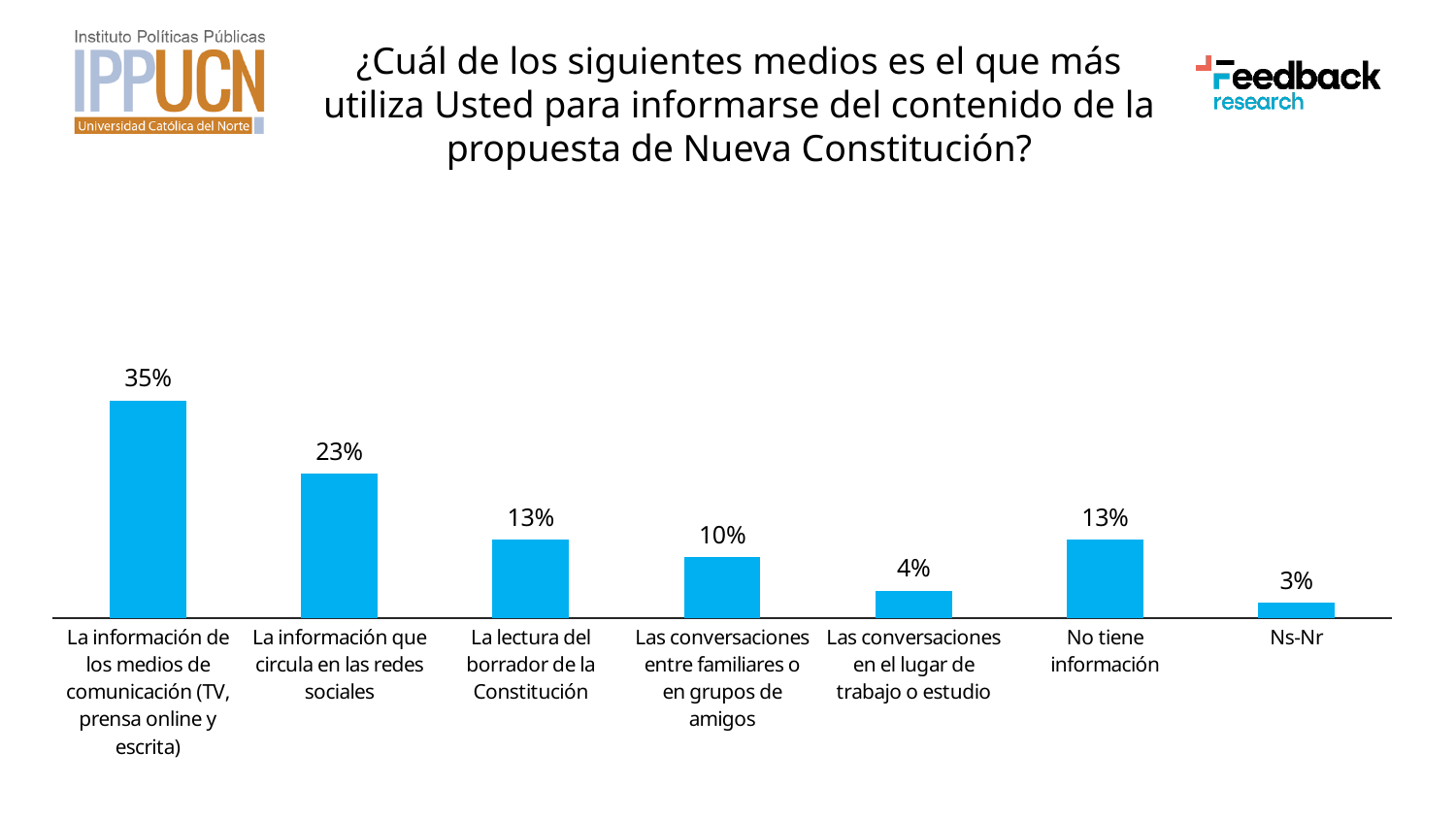
What is the value for "La información de los medios de comunicación (TV, prensa online y escrita)"? 35% What is the difference between the values for "La lectura del borrador de la Constitución" and "Ns-Nr"? 10% How many categories are shown in the chart? 7 What is the value for "La información que circula en las redes sociales"? 23% Which category has the highest value? La información de los medios de comunicación (TV, prensa online y escrita) What is the value for "Ns-Nr"? 3% Which category has the lowest value? Ns-Nr What is the value for "Las conversaciones en el lugar de trabajo o estudio"? 4% What colour are the bars in the chart? Blue What is the difference between the values for "La información de los medios de comunicación" and "La información que circula en las redes sociales"? 12% Which is larger: the value for "Las conversaciones entre familiares o en grupos de amigos" or the value for "No tiene información"? No tiene información What kind of chart is shown on the slide? Bar chart